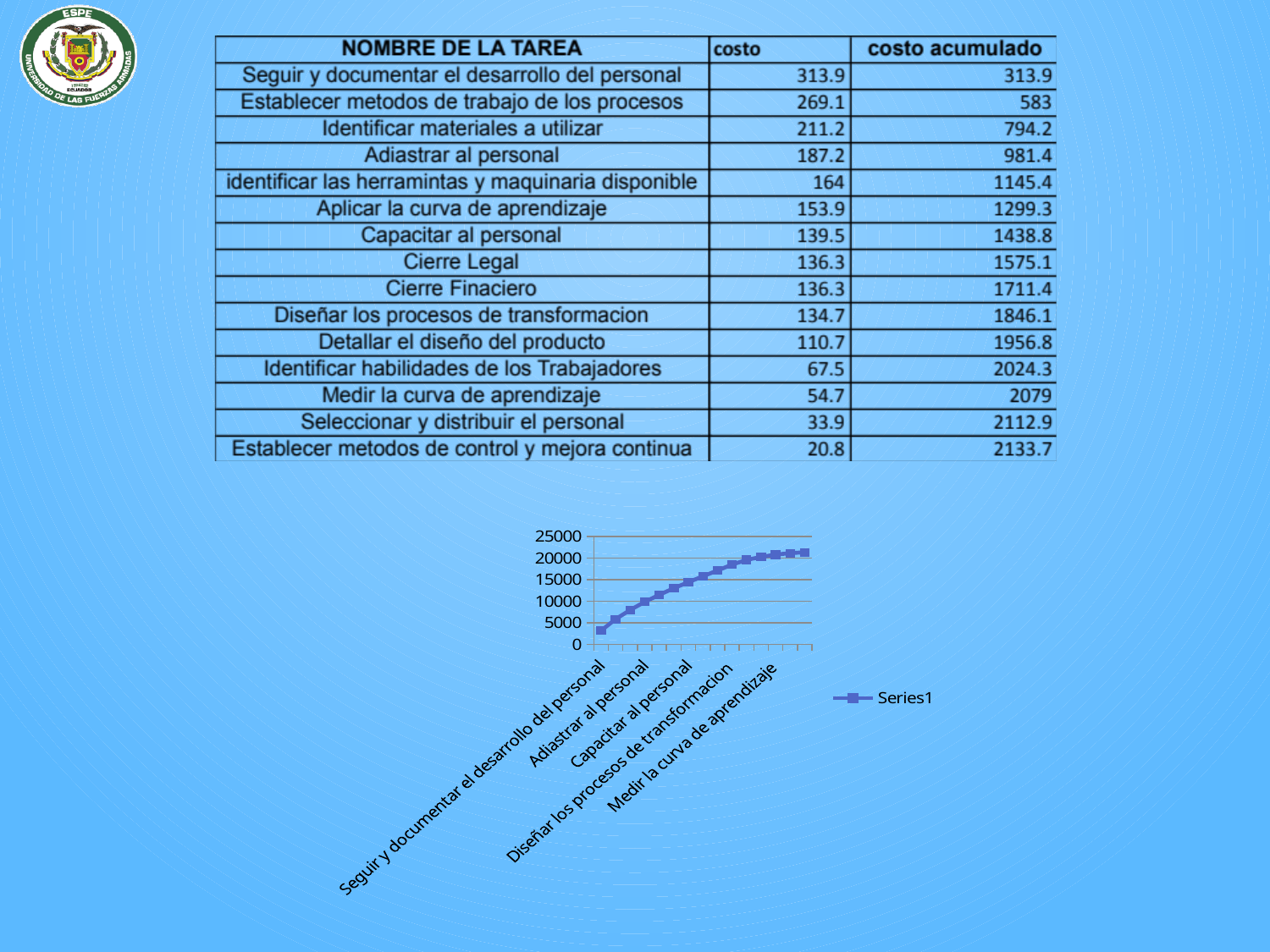
Is the value for 'Medir la curva de aprendizaje' in the chart greater or less than 15000? greater Is the value for 'Diseñar los procesos de transformacion' in the chart greater or less than 15000? greater What is the highest value shown on the chart's y axis? 25000 In the chart, which has the larger value: 'Adiastrar al personal' or 'Diseñar los procesos de transformacion'? Diseñar los procesos de transformacion What kind of chart is shown on the slide? line chart Do the values in the chart rise or fall from left to right along the x axis? rise In the chart, which has the larger value: 'Medir la curva de aprendizaje' or 'Seguir y documentar el desarrollo del personal'? Medir la curva de aprendizaje Which labelled category in the chart has the lowest value? Seguir y documentar el desarrollo del personal Is the value for 'Seguir y documentar el desarrollo del personal' in the chart greater or less than 5000? less How many series does the chart legend list? 1 What is the name of the series shown in the chart legend? Series1